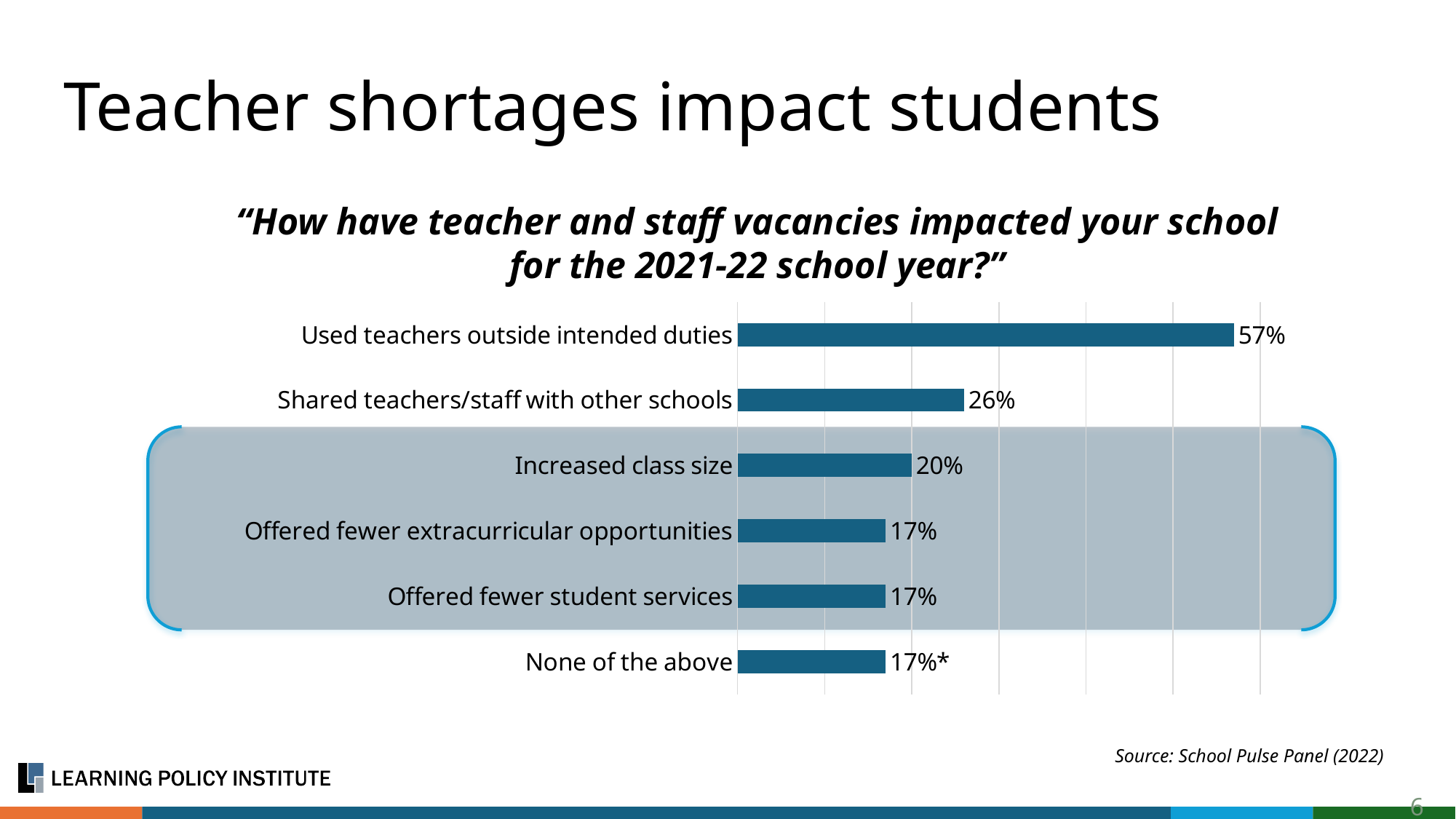
Which is larger: 'Shared teachers/staff with other schools' or 'Increased class size'? Shared teachers/staff with other schools What is the source cited for the chart? School Pulse Panel (2022) What kind of chart is shown on the slide? Bar chart Which category has the highest value? Used teachers outside intended duties What is the value for 'Shared teachers/staff with other schools'? 26% What is the value shown for 'Offered fewer extracurricular opportunities'? 17% What percentage of schools reported increased class size? 20% What percentage of schools reported using teachers outside intended duties? 57% How many categories share the value 17%? 3 What is the difference between 'Increased class size' and 'Offered fewer student services'? 3% What is the difference between 'Used teachers outside intended duties' and 'Shared teachers/staff with other schools'? 31% How many categories are shown in the chart? 6